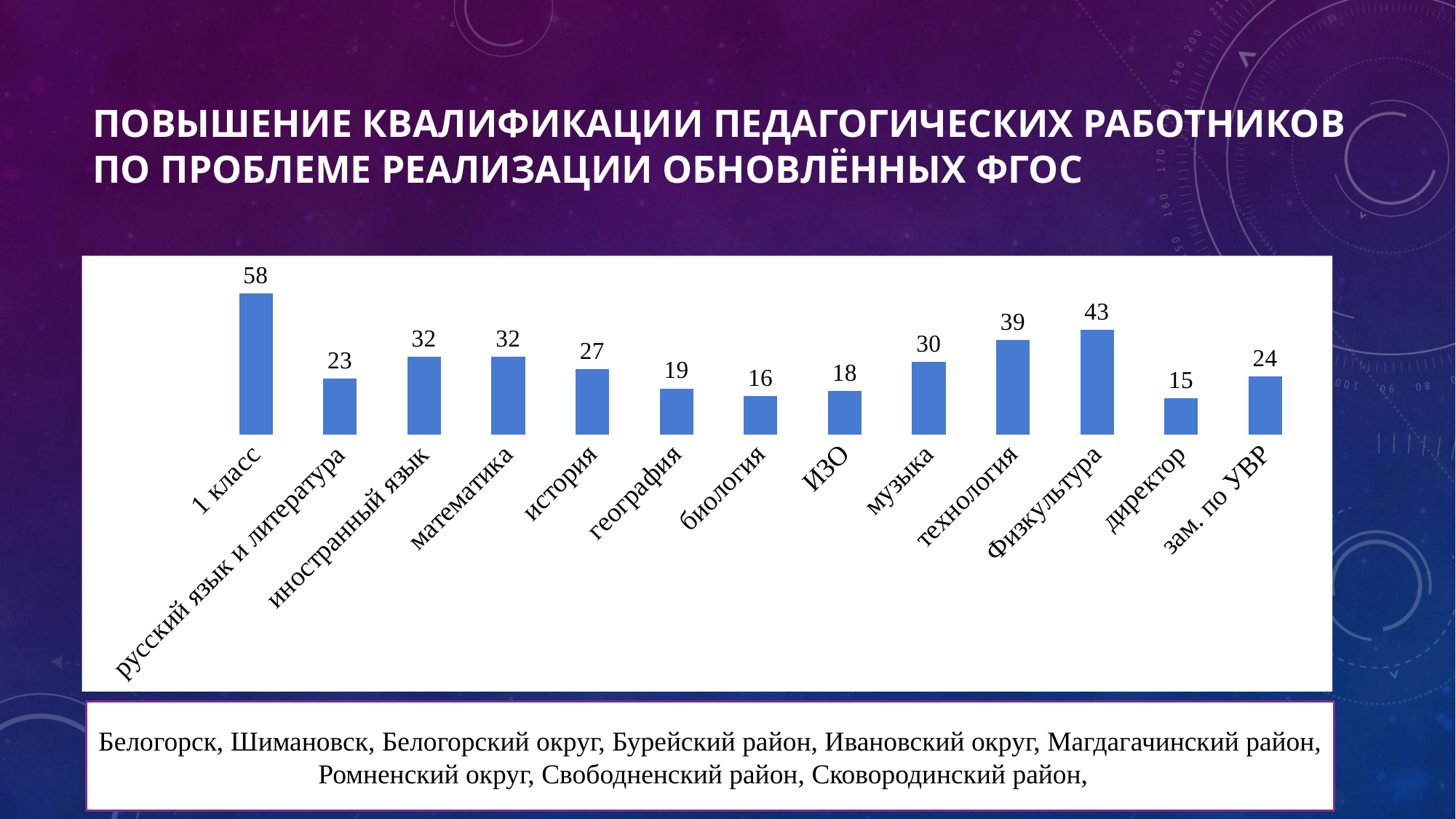
What is the value for биология? 16 What is the difference between the values for технология and музыка? 9 What is the difference between the values for 1 класс and физкультура? 15 Which category has the lowest value? директор Which is larger, the value for история or the value for география? история Which category has the highest value? 1 класс What is the value for 1 класс? 58 What is the value for зам. по УВР? 24 What is the value for физкультура? 43 What kind of chart is shown on the slide? bar chart Which two categories share the value 32? иностранный язык and математика How many categories are shown in the chart? 13